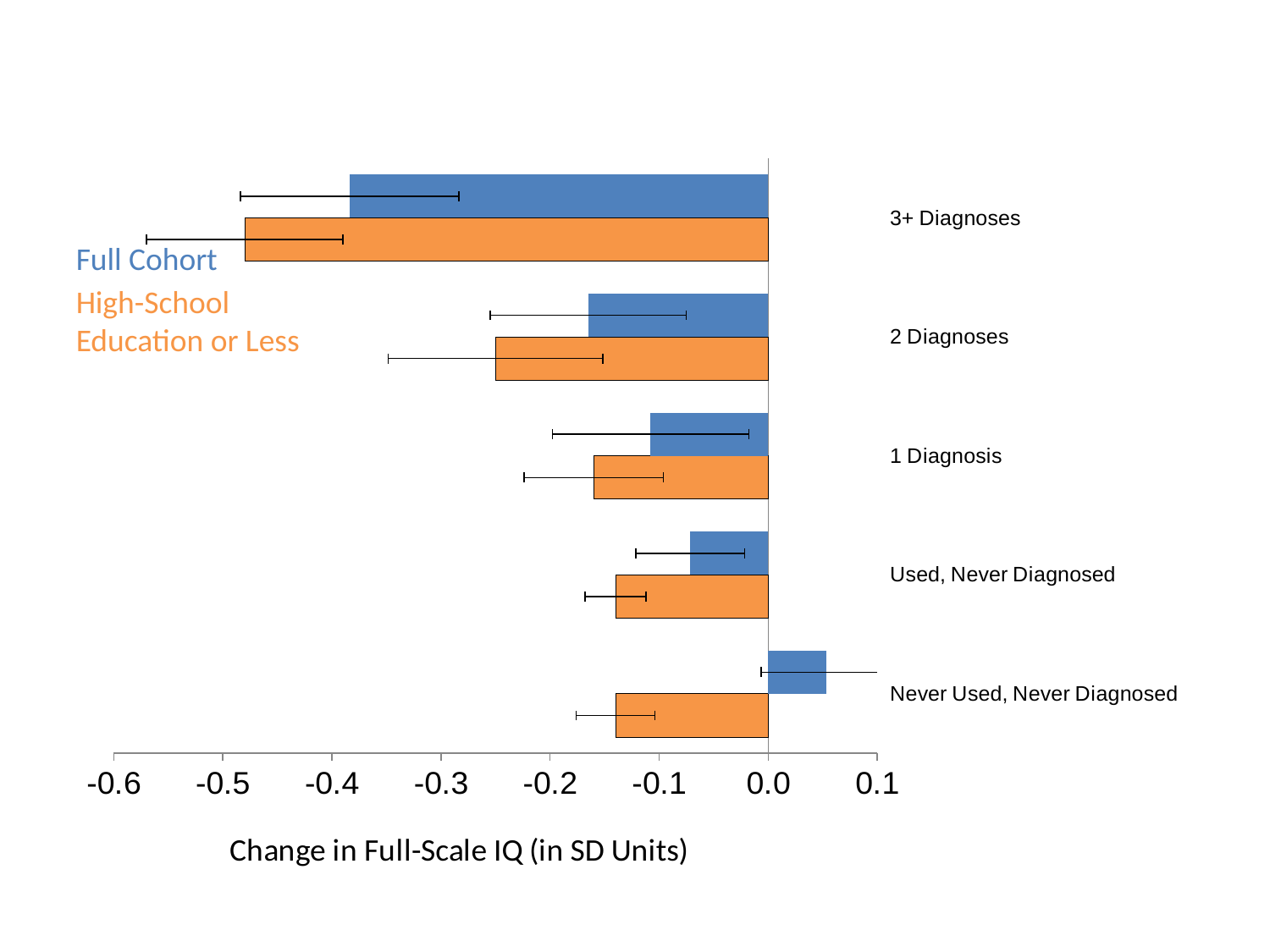
Is the Full Cohort value for Never Used, Never Diagnosed greater or less than 0.0? greater Which category has the lowest value for the Full Cohort series? 3+ Diagnoses How many categories are plotted on the chart? 5 Which category has the lowest value for the High-School Education or Less series? 3+ Diagnoses What kind of chart is shown on the slide? bar chart Is the High-School Education or Less value for 3+ Diagnoses greater or less than -0.4? less Which category has the highest value for the Full Cohort series? Never Used, Never Diagnosed What is the title of the x axis? Change in Full-Scale IQ (in SD Units) Is the Full Cohort value for 3+ Diagnoses greater or less than -0.3? less For Never Used, Never Diagnosed, which series has the larger value: Full Cohort or High-School Education or Less? Full Cohort Which colour represents the Full Cohort series? blue How many series does the chart show? 2